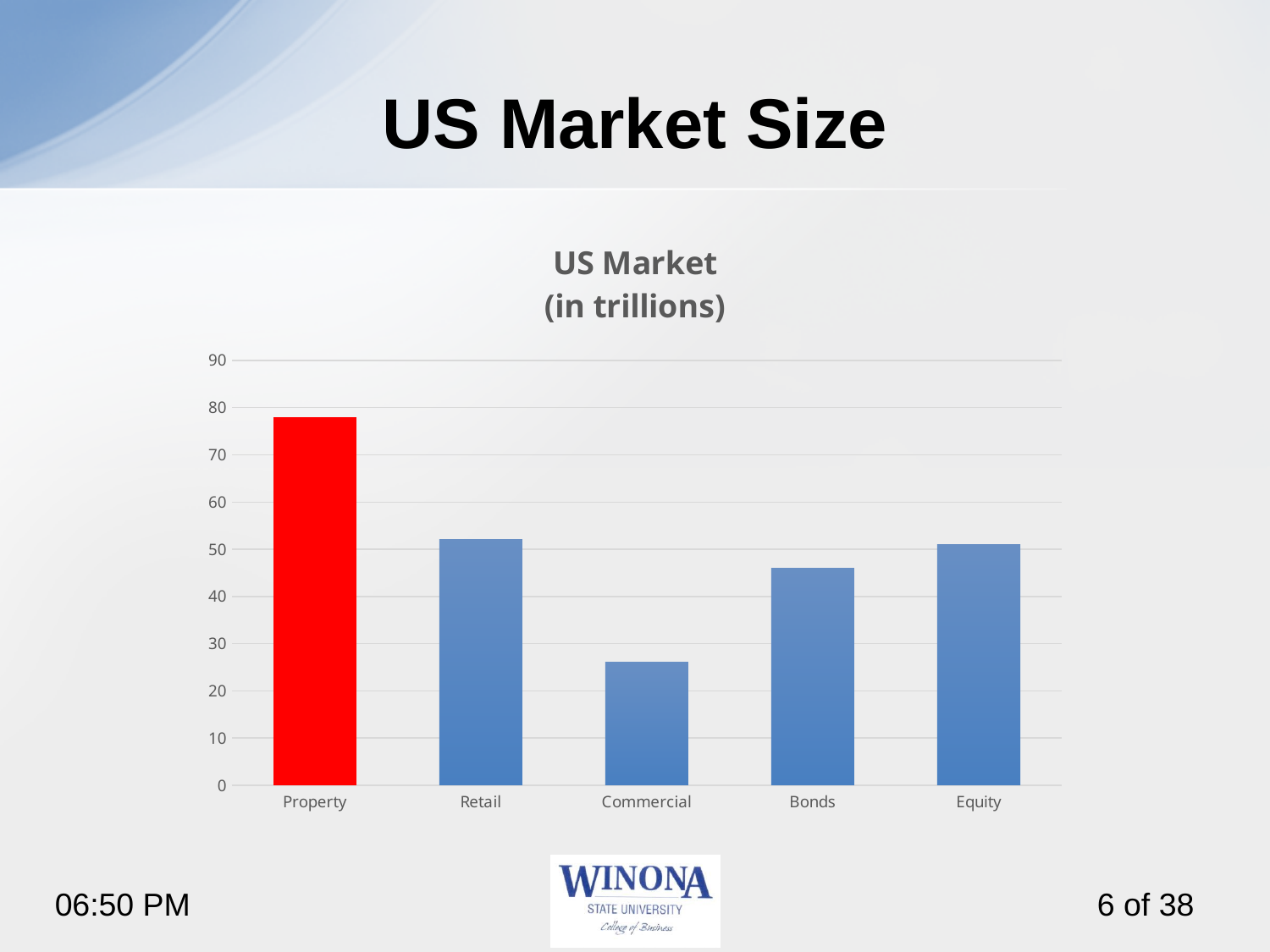
Is the value for Property greater or less than 70? greater Which is larger, the value for Retail or the value for Commercial? Retail Which category has the lowest value? Commercial What is the title of the chart? US Market (in trillions) How many categories are plotted on the chart? 5 Which category has the highest value? Property Which is larger, the value for Property or the value for Bonds? Property Is the value for Bonds greater or less than 40? greater Is the value for Commercial greater or less than 30? less What kind of chart is shown on the slide? bar chart Which bar is coloured red rather than blue? Property